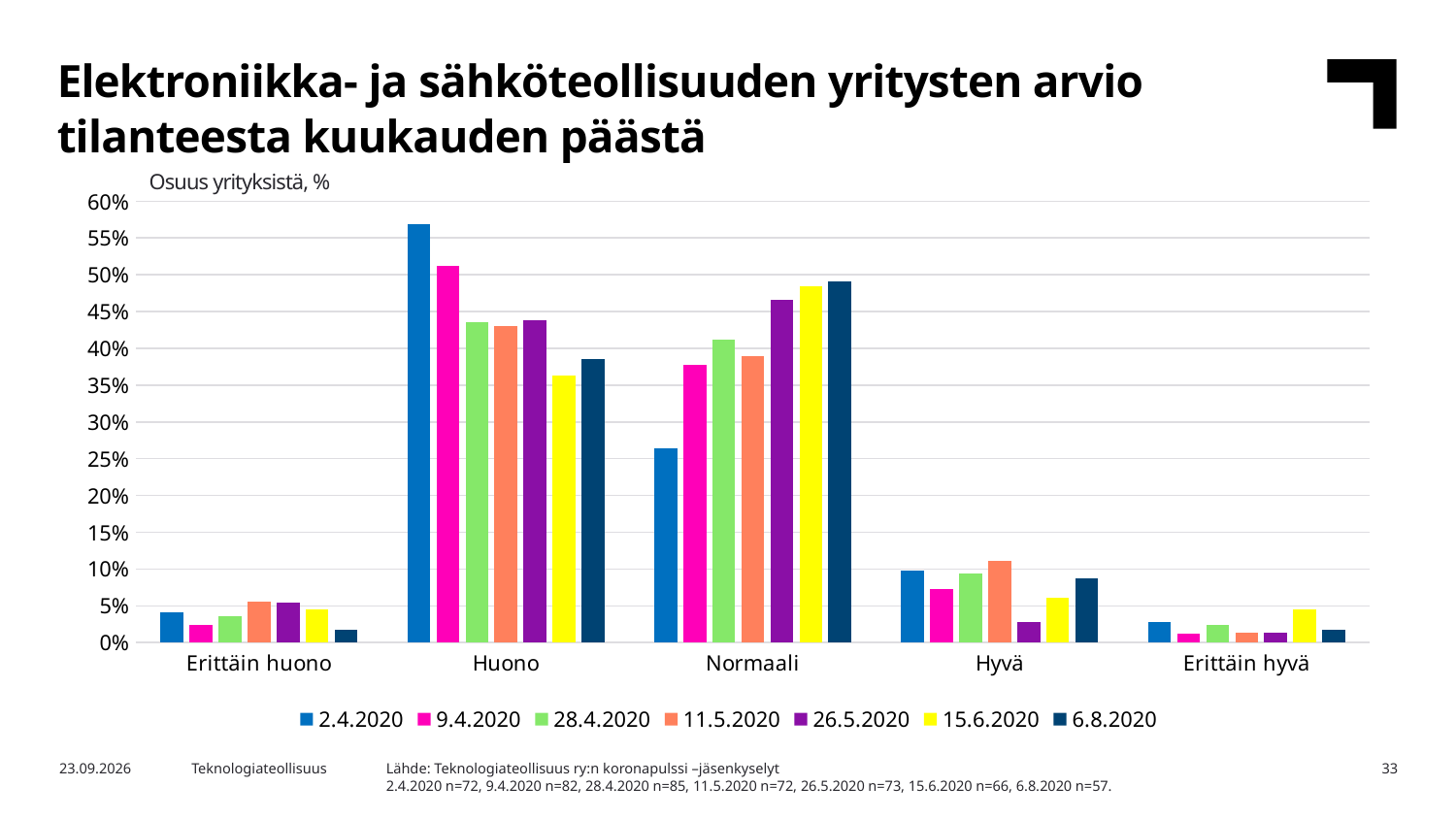
How many categories are shown on the x axis of the chart? 5 Which category has the highest value in the 6.8.2020 series? Normaali Which category has the highest value in the 2.4.2020 series? Huono For the Normaali category, which is larger: the 2.4.2020 value or the 15.6.2020 value? 15.6.2020 What label is shown above the y axis of the chart? Osuus yrityksistä, % Is the value for Huono in the 2.4.2020 series greater or less than 55%? greater What kind of chart is shown on the slide? bar chart For the Huono category, which is larger: the 2.4.2020 value or the 9.4.2020 value? 2.4.2020 For the Huono category, do the values generally rise or fall from the 2.4.2020 series to the 15.6.2020 series? fall Is the value for Normaali in the 2.4.2020 series greater or less than 30%? less How many series does the legend list? 7 Is the value for Huono in the 15.6.2020 series greater or less than 40%? less